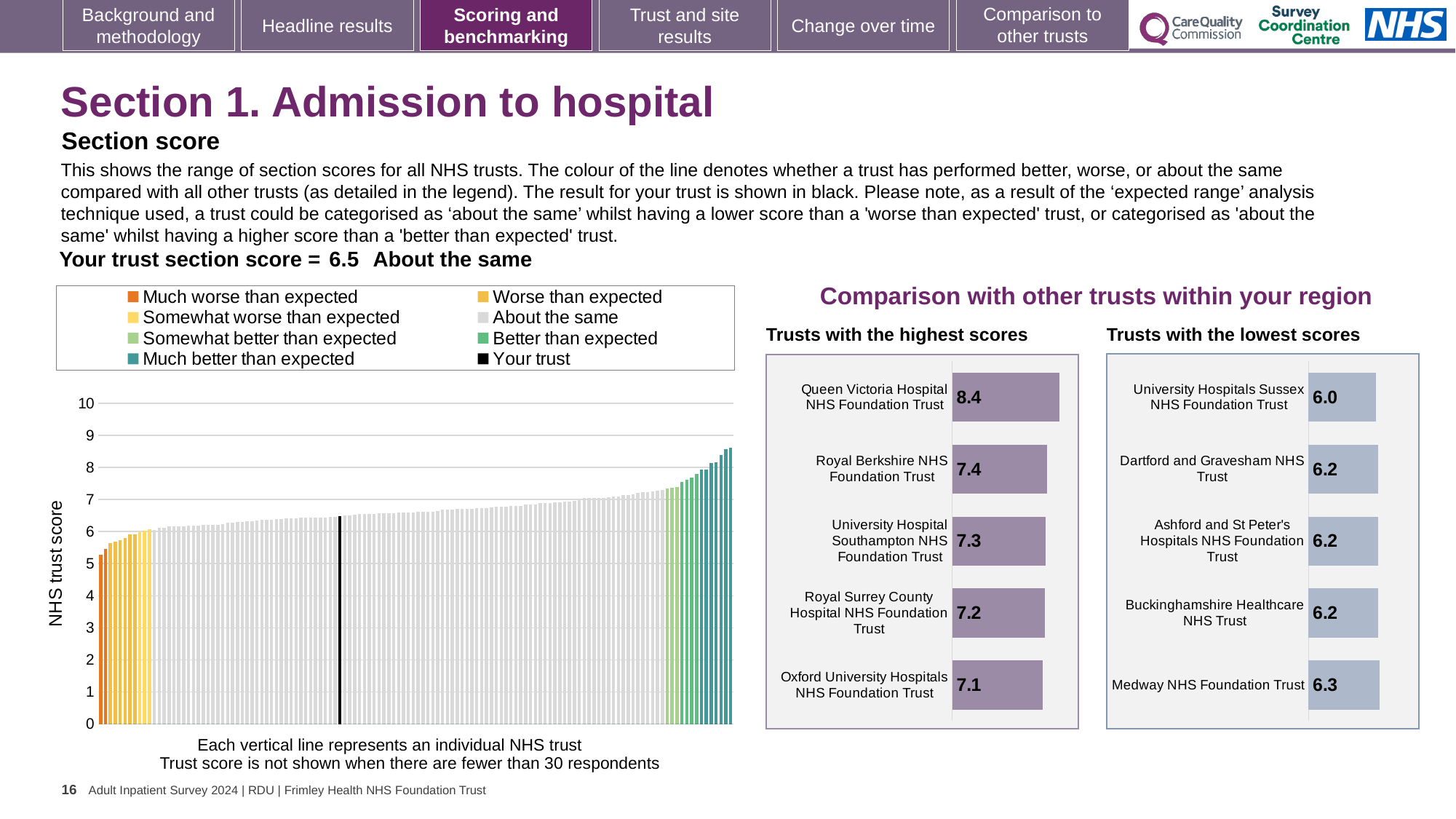
In the 'Trusts with the lowest scores' chart, what is the score for Medway NHS Foundation Trust? 6.3 In the 'Trusts with the lowest scores' chart, how much higher is Medway NHS Foundation Trust's score than University Hospitals Sussex NHS Foundation Trust's score? 0.3 What kind of chart is the 'Trusts with the lowest scores' chart? Bar chart In the main NHS trust score chart on the left, do the trust scores rise or fall from left to right? Rise In the 'Trusts with the highest scores' chart, which has the larger score: Royal Surrey County Hospital NHS Foundation Trust or Oxford University Hospitals NHS Foundation Trust? Royal Surrey County Hospital NHS Foundation Trust How many trusts are shown in the 'Trusts with the highest scores' chart? 5 In the 'Trusts with the highest scores' chart, what is the score for Queen Victoria Hospital NHS Foundation Trust? 8.4 In the 'Trusts with the highest scores' chart, which trust has the highest score? Queen Victoria Hospital NHS Foundation Trust In the 'Trusts with the highest scores' chart, what is the difference between the scores of Queen Victoria Hospital NHS Foundation Trust and Royal Berkshire NHS Foundation Trust? 1.0 In the main NHS trust score chart on the left, what is the section score for your trust (the black line)? 6.5 In the 'Trusts with the lowest scores' chart, which trust has the lowest score? University Hospitals Sussex NHS Foundation Trust In the main NHS trust score chart on the left, is the value of the tallest bar greater or less than 8? greater